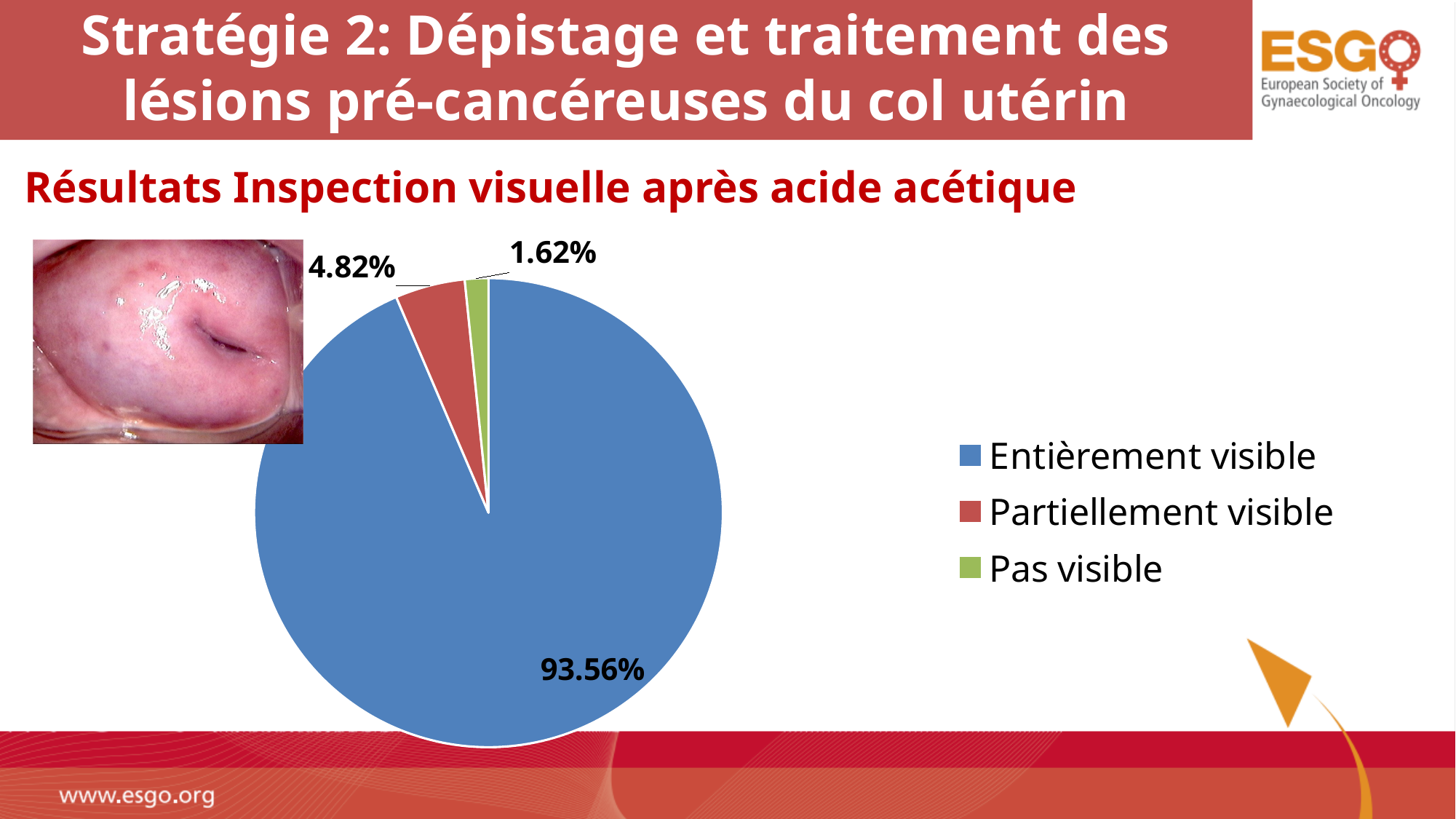
What percentage is shown for "Partiellement visible"? 4.82% Which category has the smallest share of the pie? Pas visible What percentage is shown for "Pas visible"? 1.62% What colour is the slice for "Entièrement visible"? blue Which is larger, the share for "Partiellement visible" or the share for "Pas visible"? Partiellement visible What percentage is shown for "Entièrement visible"? 93.56% What is the difference between the shares for "Partiellement visible" and "Pas visible"? 3.20% How many categories does the legend list? 3 What kind of chart is shown on the slide? pie chart What is the difference between the shares for "Entièrement visible" and "Partiellement visible"? 88.74% Which category has the largest share of the pie? Entièrement visible What colour is the slice for "Pas visible"? green